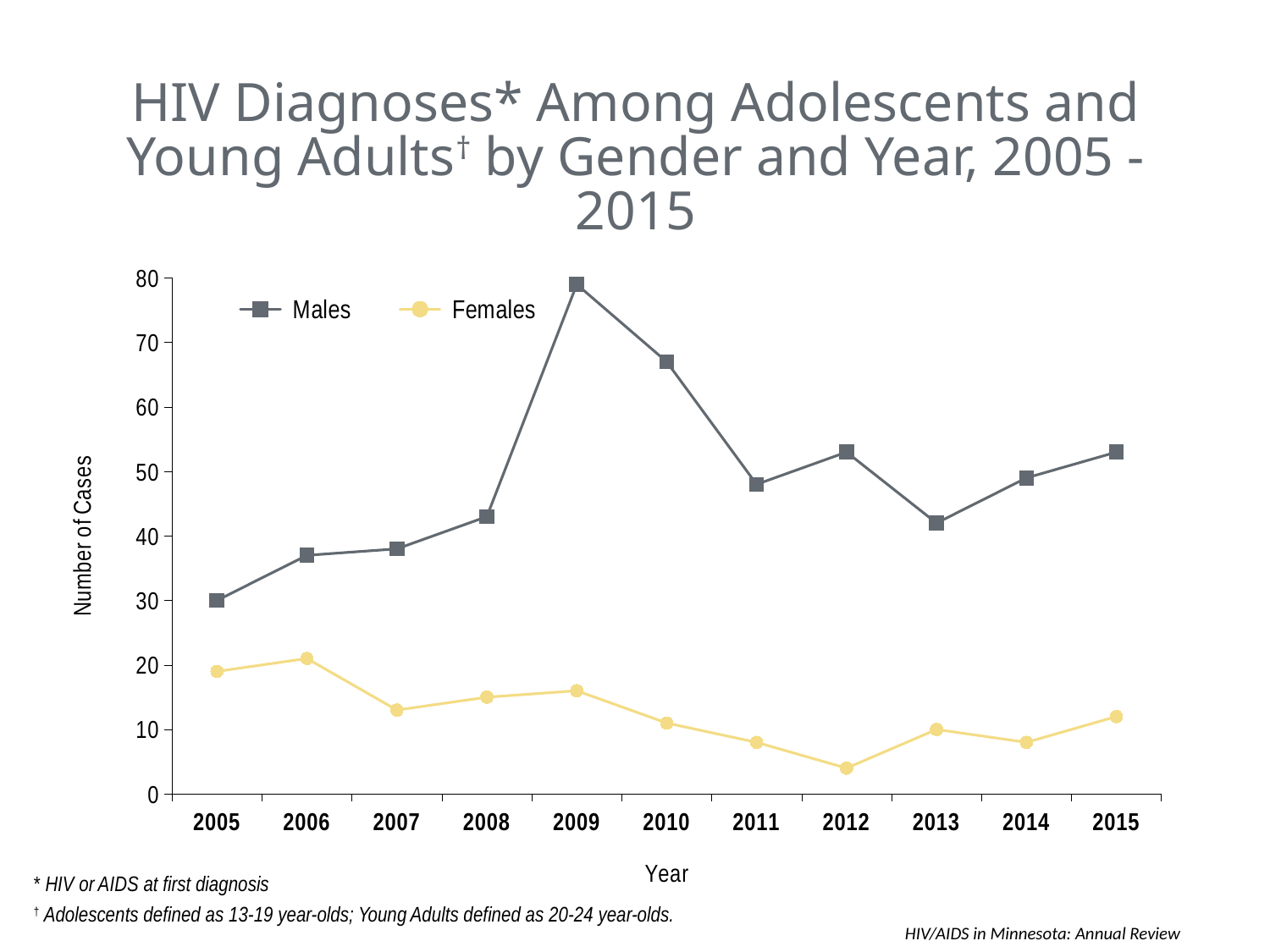
Is the value for Females in 2012 greater or less than 10? less Is the value for Males in 2013 greater or less than 40? greater What are the two series named in the legend? Males and Females How many years are shown along the x axis? 11 In which year is the number of cases for Females lowest? 2012 Is the value for Males in 2009 greater or less than 70? greater What is the label of the y axis? Number of Cases Which series has the larger value in 2015, Males or Females? Males Do the values for Males rise or fall from 2005 to 2009? Rise How many series does the legend list? 2 In which year is the number of cases for Males highest? 2009 What kind of chart is shown on the slide? Line chart